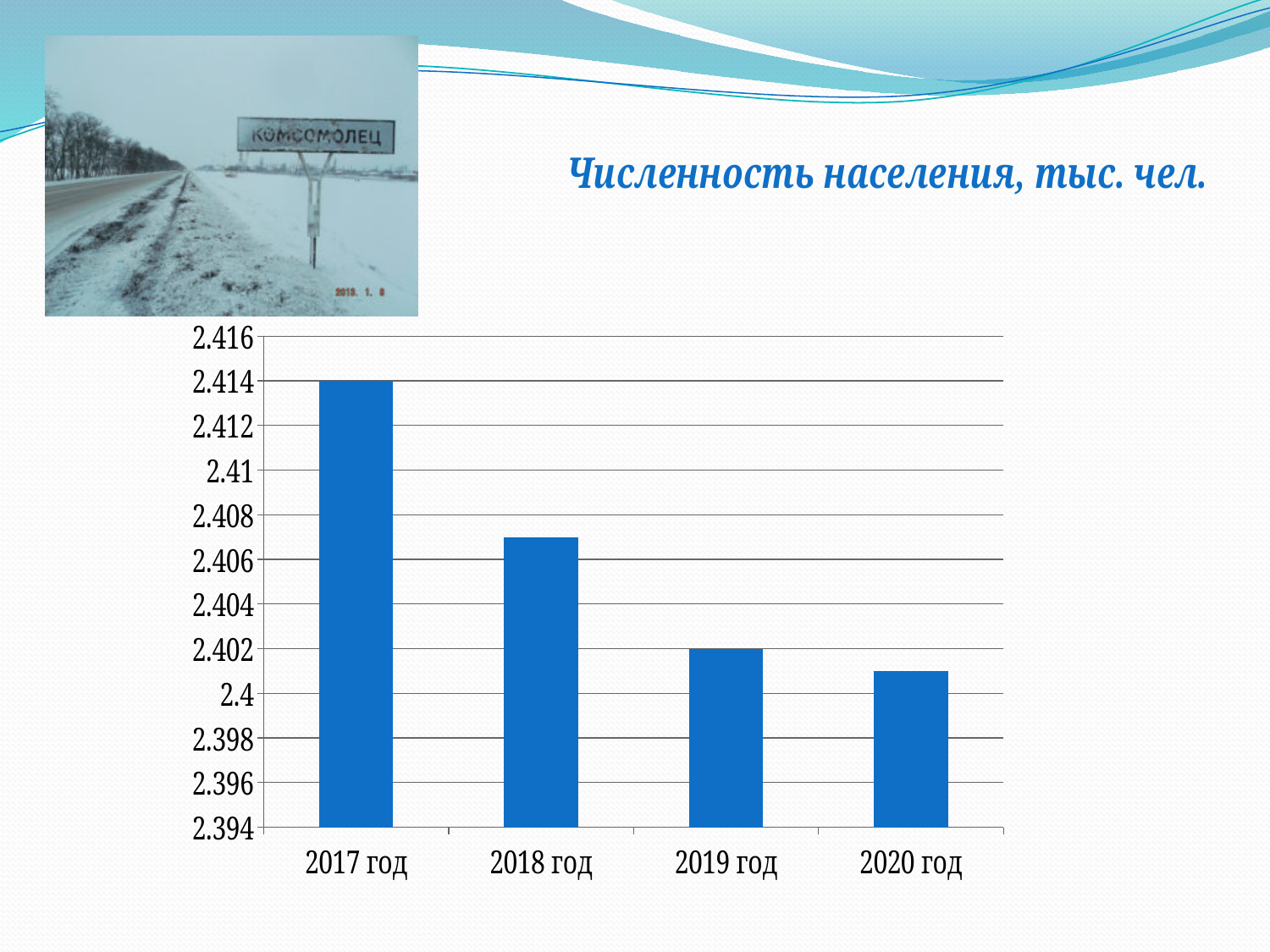
What kind of chart is shown on the slide? bar chart What is the difference between the values for 2017 год and 2019 год? 0.012 What is the value for 2017 год? 2.414 Do the values rise or fall from 2017 год to 2020 год? fall How many years are shown on the x axis of the chart? 4 Which year has the highest value? 2017 год Which year has the lowest value? 2020 год Is the value for 2018 год greater or less than 2.406? greater What is the title of the chart? Численность населения, тыс. чел. Is the value for 2020 год greater or less than 2.402? less Which is larger, the value for 2018 год or the value for 2019 год? 2018 год What is the value for 2019 год? 2.402